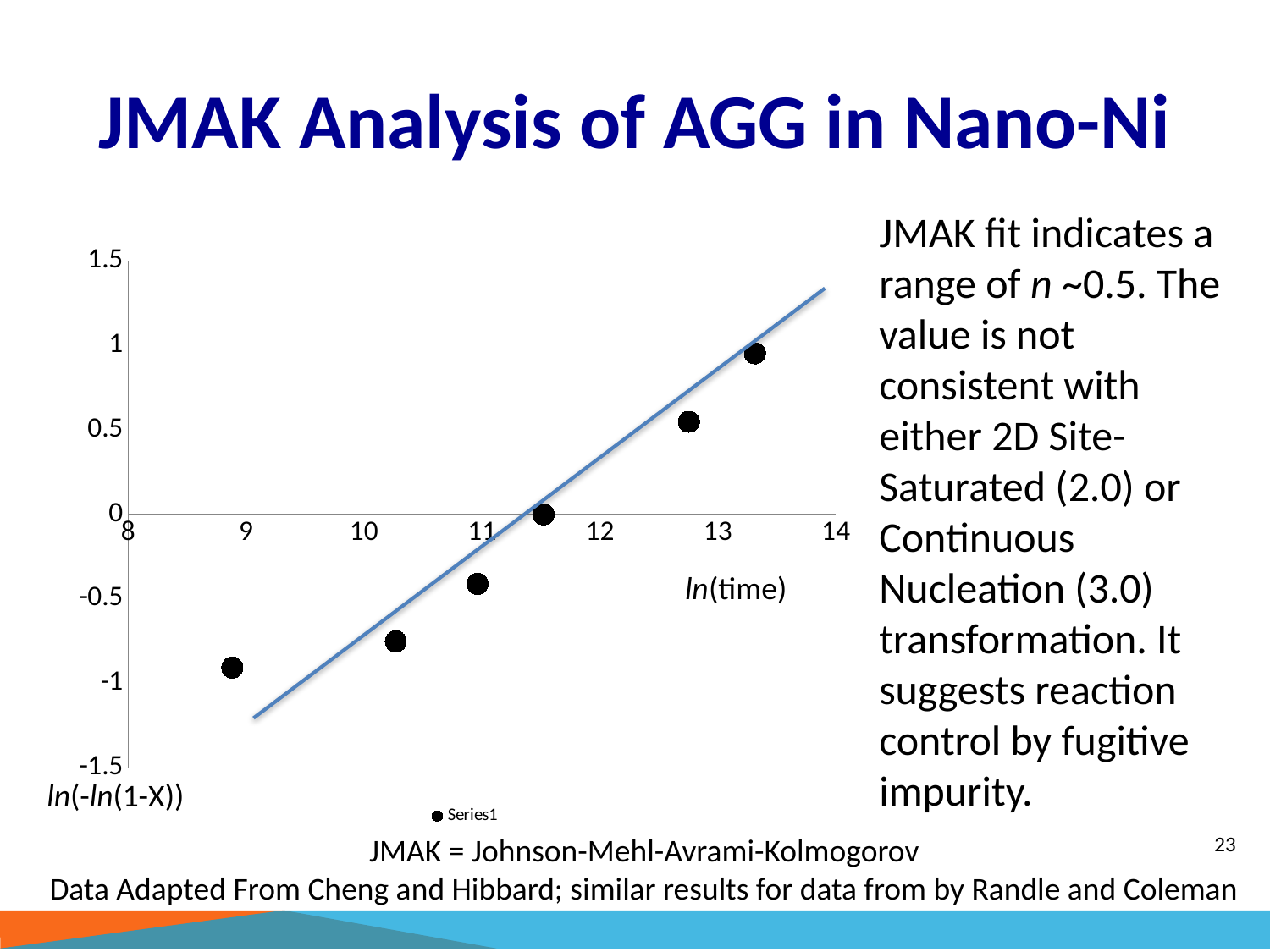
What is the maximum value shown on the y axis? 1.5 Is the value of the data point near ln(time) = 10.3 greater or less than -0.5? less What kind of chart is shown on the slide? scatter chart Is the value of the rightmost data point (near ln(time) = 13.3) greater or less than 0.5? greater What is the name of the series shown in the legend? Series1 How many data points are plotted in the chart? 6 What is the label of the x axis? ln(time) Is the value of the data point near ln(time) = 12.75 greater or less than 0? greater Which data point has the highest value: the leftmost point or the rightmost point? the rightmost point Do the plotted values rise or fall as ln(time) increases along the x axis? rise How many series does the chart legend list? 1